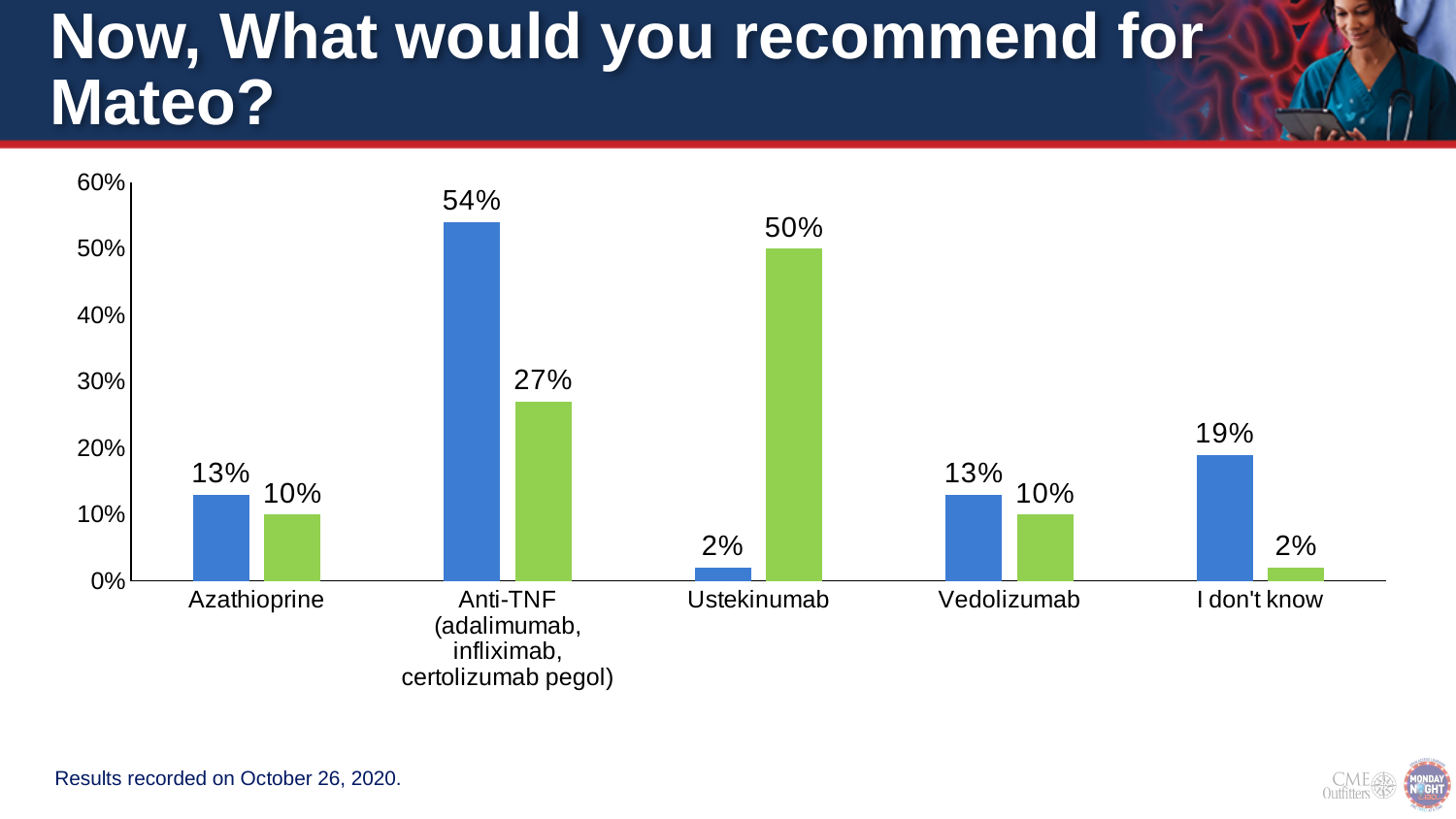
Is the green bar for Ustekinumab greater or less than 40%? greater What is the value of the green bar for Vedolizumab? 10% What kind of chart is shown on the slide? bar chart What is the title of the slide containing the chart? Now, What would you recommend for Mateo? What is the difference between the blue and green bars for Anti-TNF (adalimumab, infliximab, certolizumab pegol)? 27% What is the value of the blue bar for Anti-TNF (adalimumab, infliximab, certolizumab pegol)? 54% What is the value of the green bar for Ustekinumab? 50% How many categories are shown on the x axis? 5 Which category has the highest blue bar? Anti-TNF (adalimumab, infliximab, certolizumab pegol) What is the value of the blue bar for I don't know? 19% For Ustekinumab, which bar is larger, the blue or the green? green Which category has the lowest green bar? I don't know